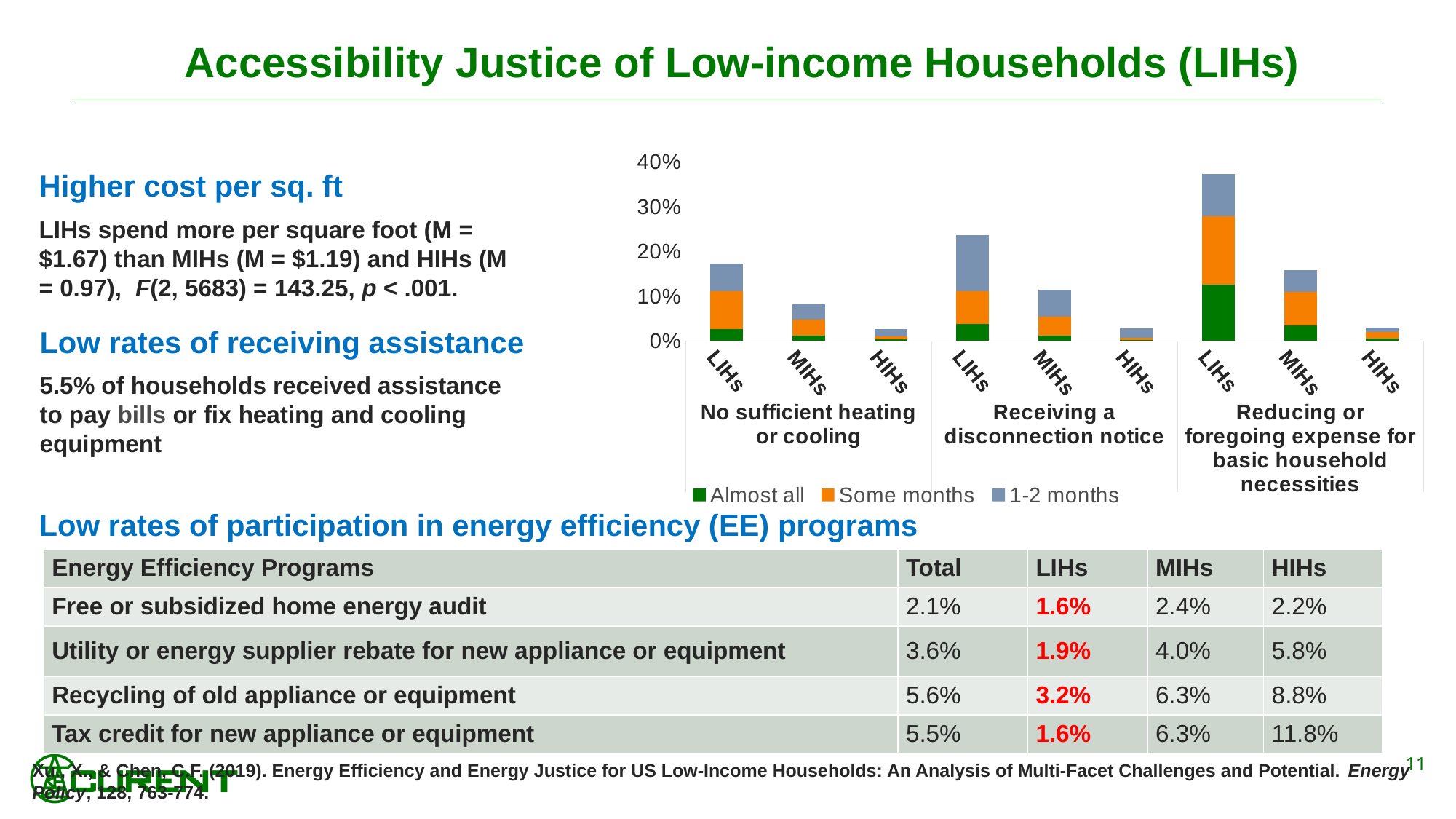
How many series does the chart's legend list? 3 What are the three series listed in the chart's legend? Almost all, Some months, 1-2 months Is the total for LIHs under 'Receiving a disconnection notice' greater or less than 20%? greater Which bar in the chart has the highest total? LIHs under Reducing or foregoing expense for basic household necessities Is the total for LIHs under 'No sufficient heating or cooling' greater or less than 20%? less How many stacked bars are plotted in the chart? 9 Within the 'Reducing or foregoing expense for basic household necessities' group, do the bar totals rise or fall from LIHs to HIHs? fall Which colour represents the 'Almost all' series in the chart? Green Is the total for MIHs under 'No sufficient heating or cooling' greater or less than 10%? less What kind of chart is shown on the slide? Stacked bar chart Within the 'Receiving a disconnection notice' group, which has the larger total, LIHs or MIHs? LIHs